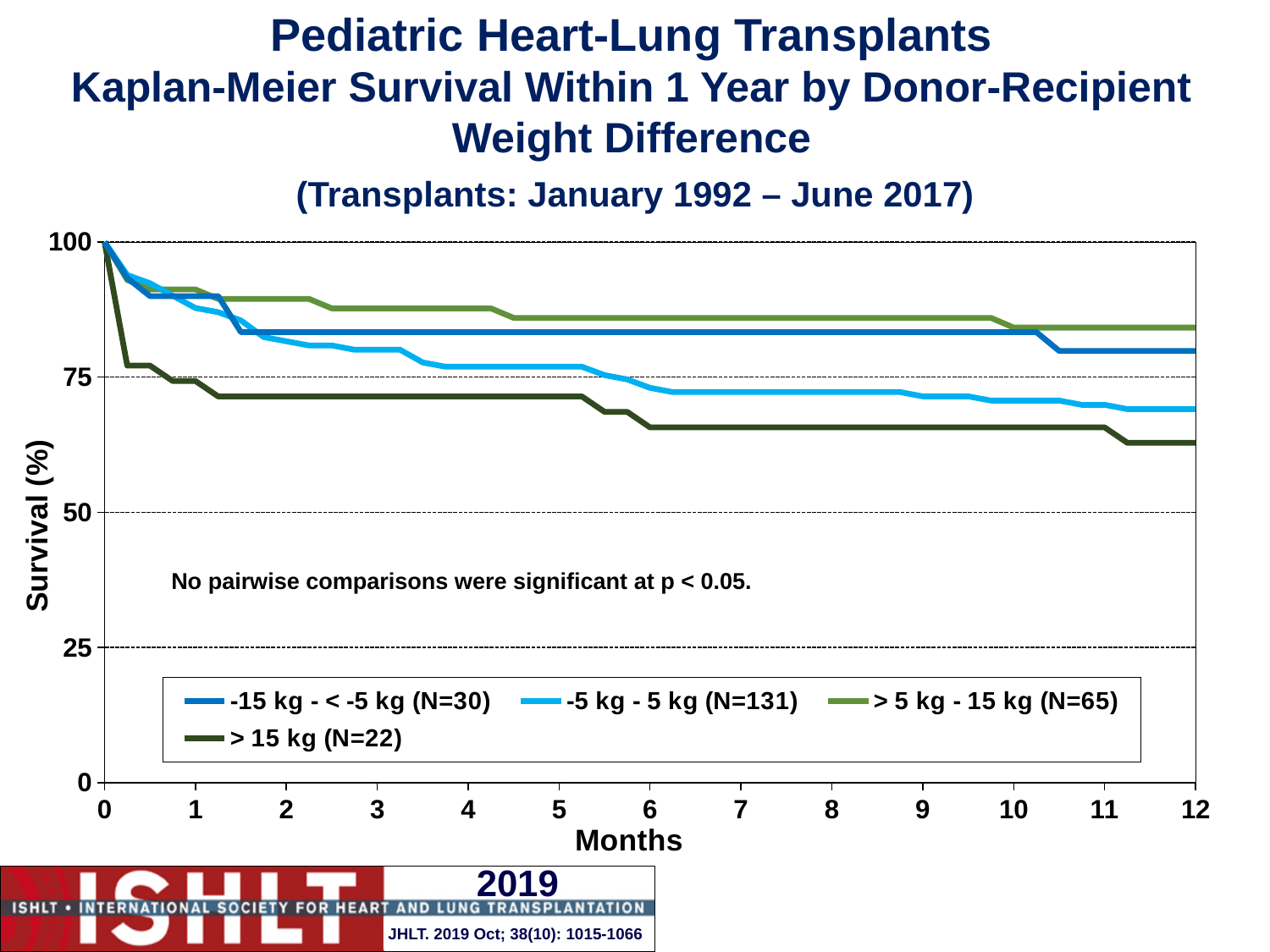
At 12 months, which group has the lowest survival? > 15 kg (N=22) At 12 months, which has higher survival: the -15 kg - < -5 kg group or the -5 kg - 5 kg group? -15 kg - < -5 kg What kind of chart is shown on the slide? Line chart How many series does the legend list? 4 At 12 months, is the survival for the > 15 kg group greater or less than 75? less What is the N for the -5 kg - 5 kg group shown in the legend? 131 Do the survival curves rise or fall as months increase? Fall At 12 months, which group has the highest survival? > 5 kg - 15 kg (N=65) At 12 months, is the survival for the > 5 kg - 15 kg group greater or less than 75? greater At 12 months, is the survival for the -5 kg - 5 kg group greater or less than 75? less What is the survival value for all groups at month 0? 100 What is the label of the x axis? Months